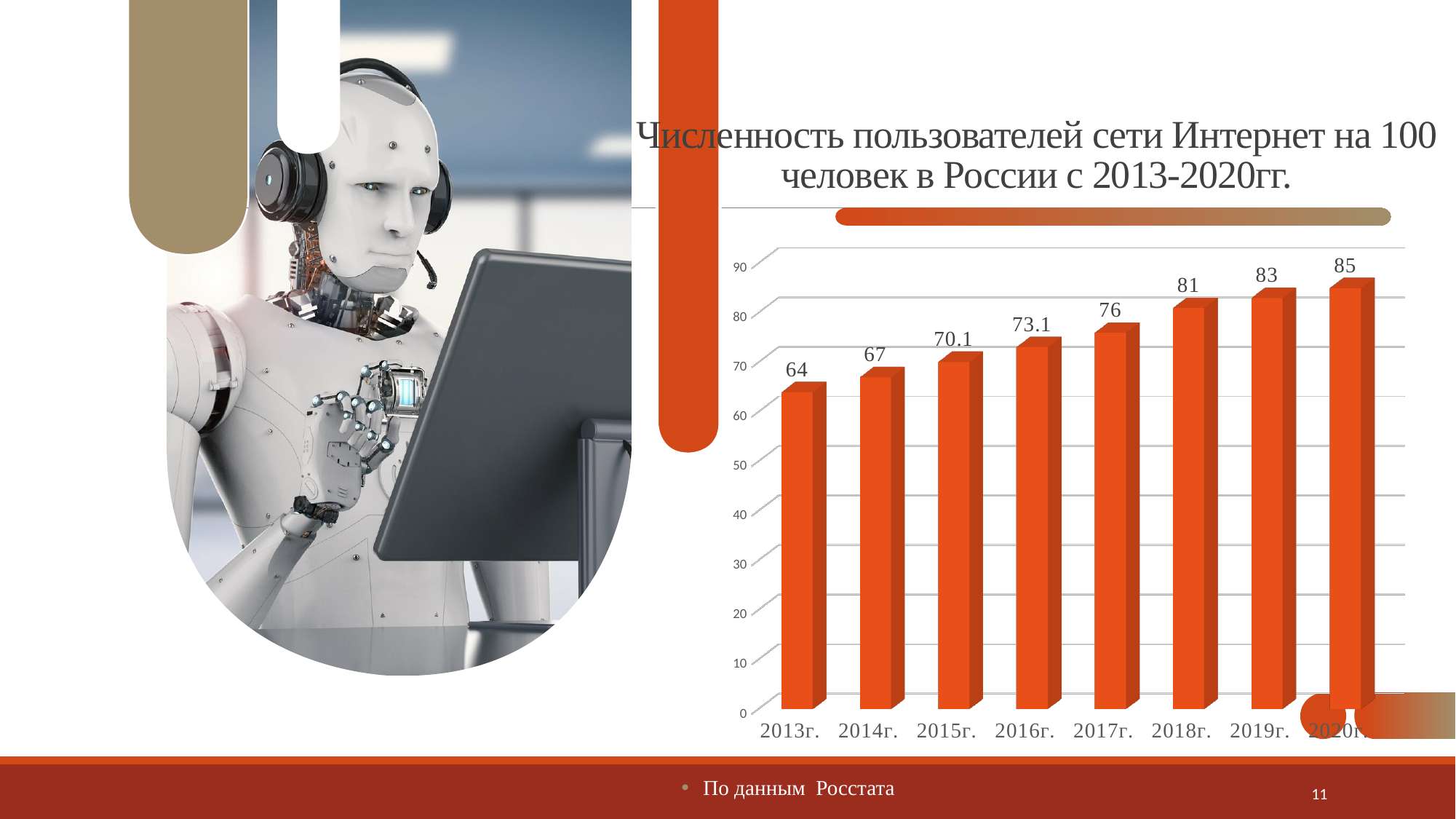
Which year has the lowest value? 2013г. What is the value for 2019г.? 83 What is the difference between the values for 2020г. and 2013г.? 21 Which is larger, the value for 2017г. or the value for 2018г.? 2018г. Which year has the highest value? 2020г. What is the value for 2013г.? 64 What kind of chart is shown on the slide? bar chart How many years are shown on the x axis? 8 What is the value for 2016г.? 73.1 Do the values rise or fall from 2013г. to 2020г.? rise What is the difference between the values for 2015г. and 2014г.? 3.1 Is the value for 2014г. greater or less than 70? less